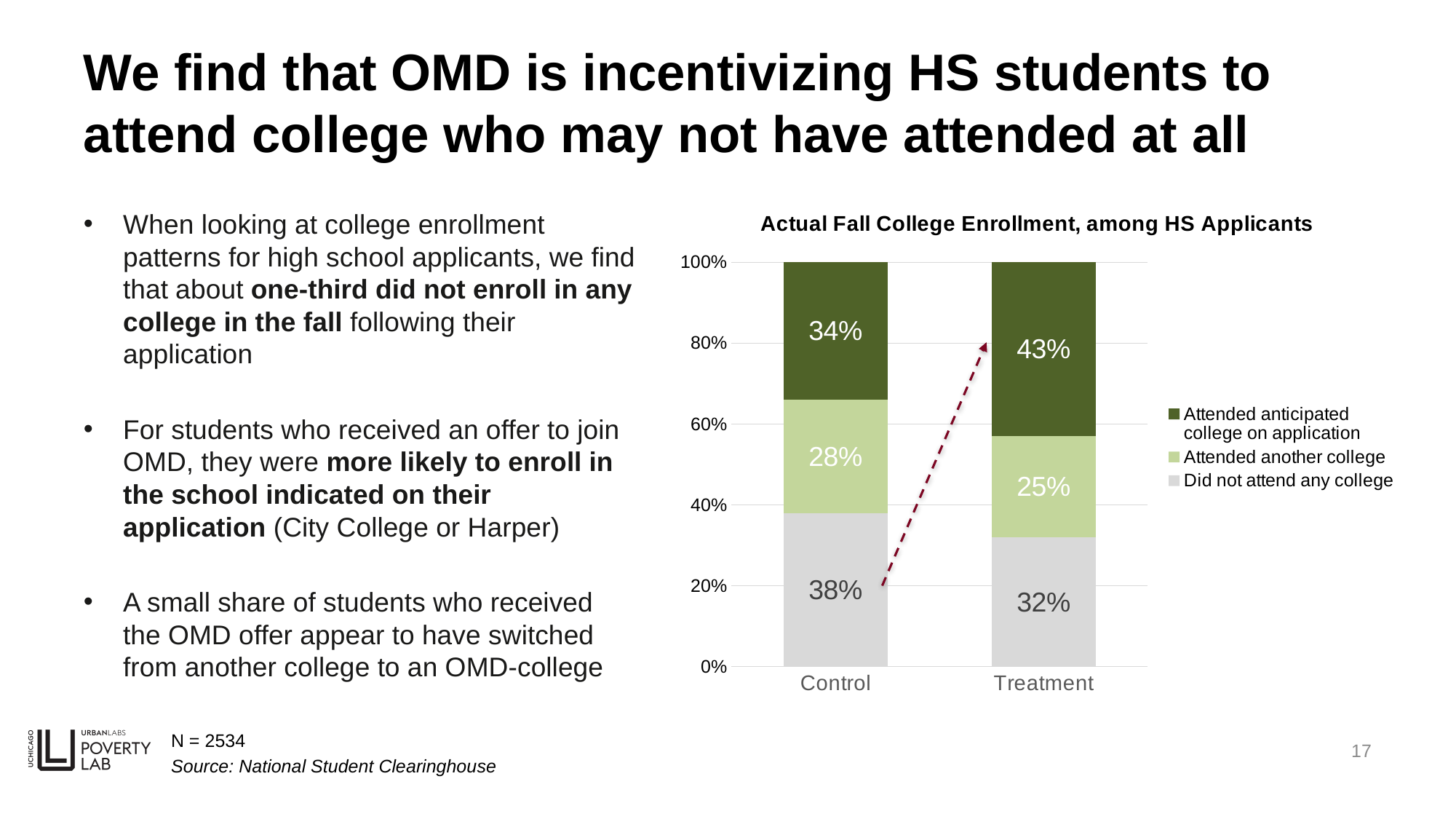
Which legend entry is shown in the darkest green colour? Attended anticipated college on application What is the difference in the share attending another college between the Control and Treatment groups? 3 percentage points How many series does the chart legend list? 3 Which group has the higher share of students who did not attend any college, Control or Treatment? Control How many groups (bars) are shown on the x axis of the chart? 2 What percentage of the Control group attended another college? 28% What percentage of the Treatment group did not attend any college? 32% What percentage of the Treatment group attended their anticipated college on application? 43% What percentage of the Control group attended their anticipated college on application? 34% What type of chart is shown on the slide? Stacked bar chart What is the difference in the share attending their anticipated college between the Treatment and Control groups? 9 percentage points What is the title of the chart? Actual Fall College Enrollment, among HS Applicants